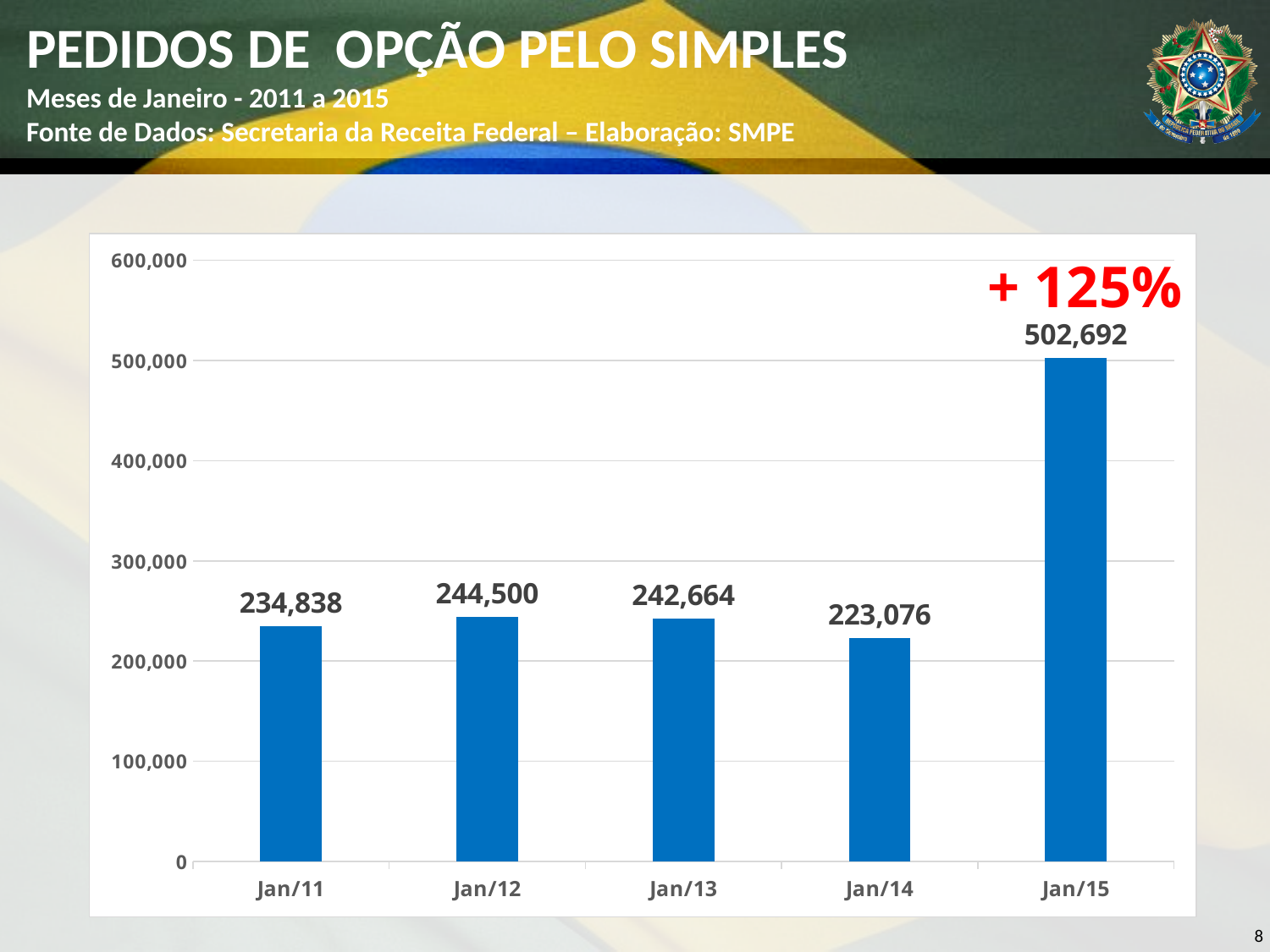
What kind of chart is shown on the slide? bar chart Which is larger, the value for Jan/12 or the value for Jan/14? Jan/12 What is the difference between the values for Jan/12 and Jan/11? 9,662 Which category has the lowest value? Jan/14 What is the difference between the values for Jan/15 and Jan/14? 279,616 Which category has the highest value? Jan/15 What is the value for Jan/15? 502,692 What percentage change is annotated in red above the Jan/15 bar? + 125% What is the value for Jan/14? 223,076 Is the value for Jan/15 greater or less than 500,000? greater What is the value for Jan/11? 234,838 How many categories are shown on the x axis? 5